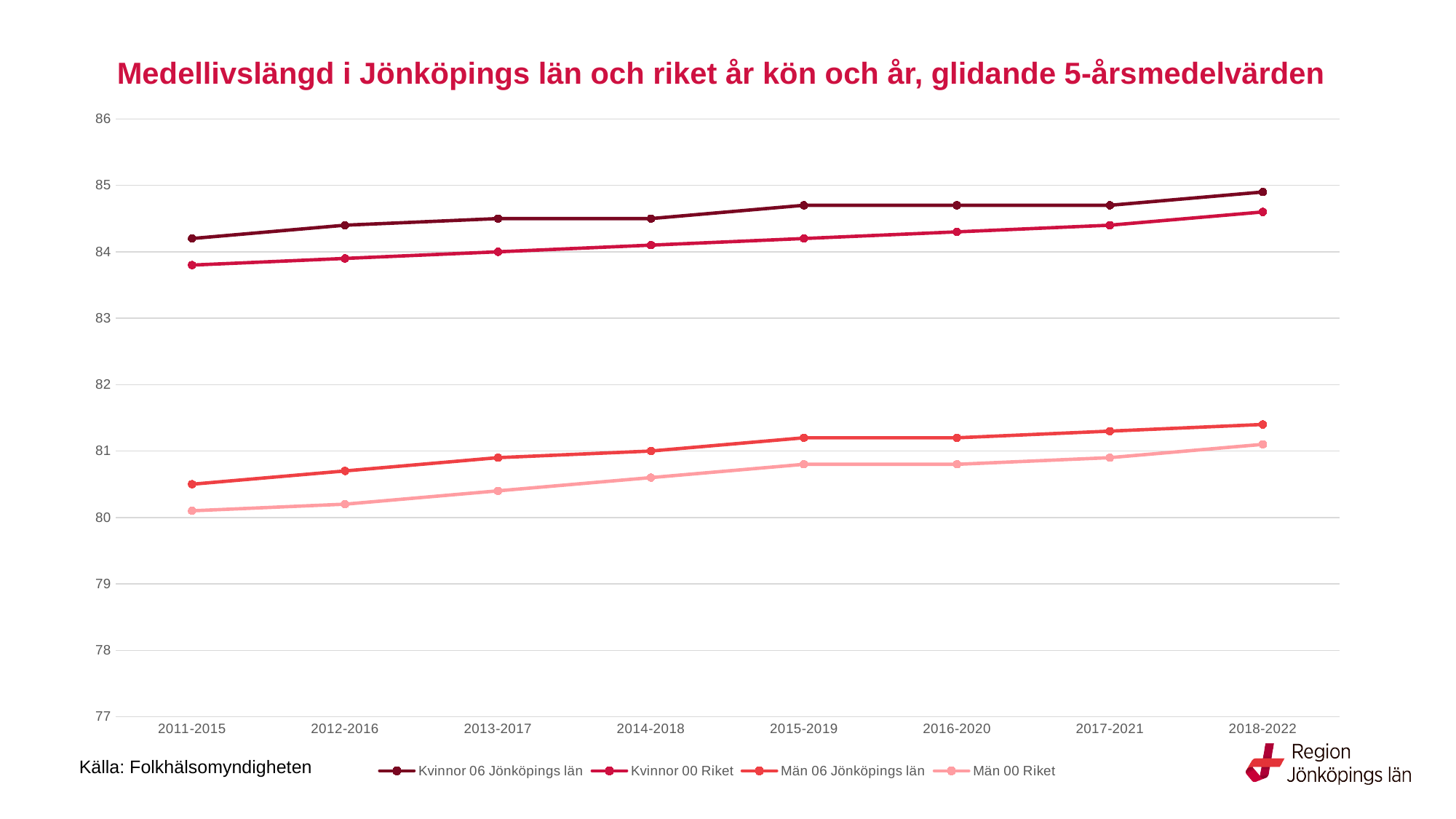
Which is larger in 2018-2022: Kvinnor 06 Jönköpings län or Män 06 Jönköpings län? Kvinnor 06 Jönköpings län How many series does the legend list? 4 What source is cited below the chart? Folkhälsomyndigheten Do the values for Män 00 Riket rise or fall from 2011-2015 to 2018-2022? rise Which series has the lowest values across the chart? Män 00 Riket What kind of chart is shown on the slide? line chart How many periods are shown along the x axis? 8 Is the value for Kvinnor 06 Jönköpings län in 2018-2022 greater or less than 85? less Is the value for Kvinnor 06 Jönköpings län in 2011-2015 greater or less than 84? greater Which series has the highest values across the chart? Kvinnor 06 Jönköpings län Is the value for Kvinnor 00 Riket in 2011-2015 greater or less than 84? less